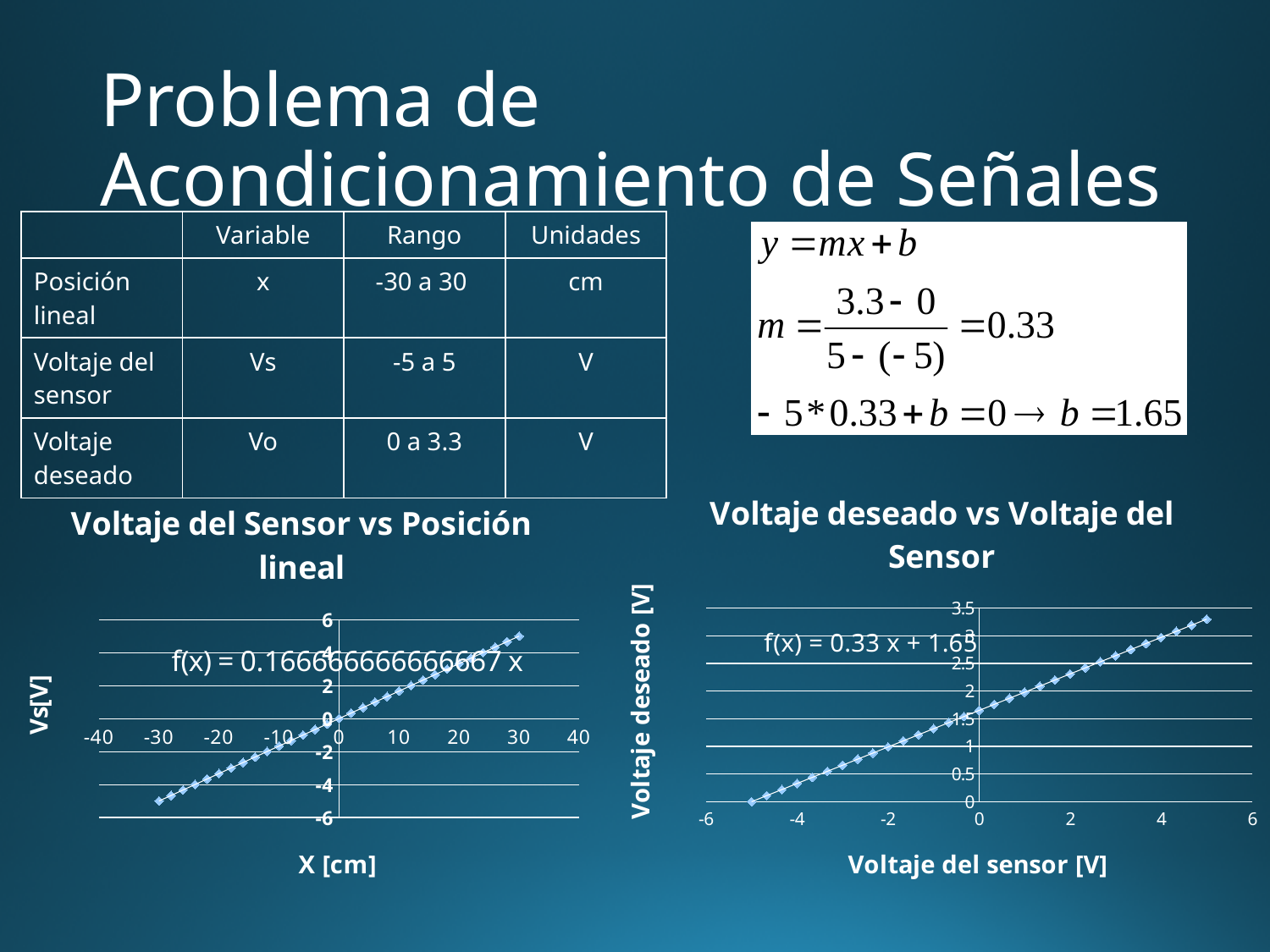
In the 'Voltaje deseado vs Voltaje del Sensor' chart, is the desired voltage at a sensor voltage of -4 V greater or less than 0.5? less In the 'Voltaje del Sensor vs Posición lineal' chart, do the values rise or fall as X increases? rise In the 'Voltaje del Sensor vs Posición lineal' chart, is the value of Vs at X = 30 cm greater or less than 4? greater In the 'Voltaje del Sensor vs Posición lineal' chart, at which X value is Vs lowest? -30 What kind of chart is the 'Voltaje deseado vs Voltaje del Sensor' chart? scatter chart What trendline equation is shown on the 'Voltaje deseado vs Voltaje del Sensor' chart? f(x) = 0.33 x + 1.65 In the 'Voltaje deseado vs Voltaje del Sensor' chart, do the values rise or fall as the sensor voltage increases? rise In the 'Voltaje del Sensor vs Posición lineal' chart, at which X value is Vs highest? 30 What kind of chart is the 'Voltaje del Sensor vs Posición lineal' chart? scatter chart What trendline equation is shown on the 'Voltaje del Sensor vs Posición lineal' chart? f(x) = 0.166666666666667 x In the 'Voltaje del Sensor vs Posición lineal' chart, is the value of Vs at X = -30 cm greater or less than -4? less